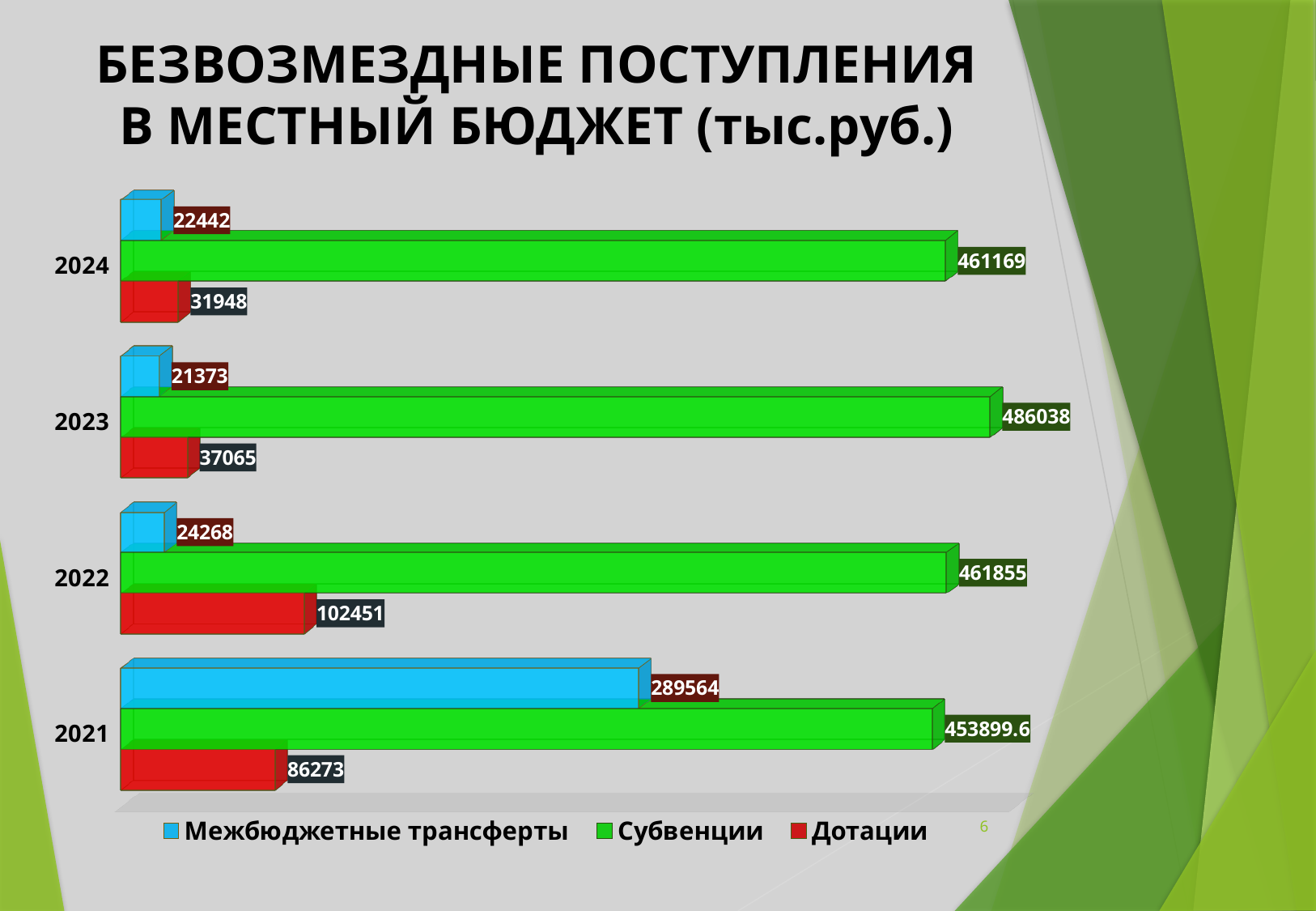
In which year is the value of Субвенции the highest? 2023 How many years are shown on the chart? 4 What is the value of Дотации for 2022? 102451 What is the difference between Дотации in 2023 and in 2024? 5117 What is the difference between Субвенции in 2023 and in 2022? 24183 What kind of chart is shown on the slide? Bar chart What is the value of Межбюджетные трансферты for 2021? 289564 How many series does the legend list? 3 Which year has the larger value of Дотации, 2021 or 2022? 2022 In which year is the value of Межбюджетные трансферты the lowest? 2023 Which colour represents Субвенции in the legend? Green What is the value of Субвенции for 2023? 486038